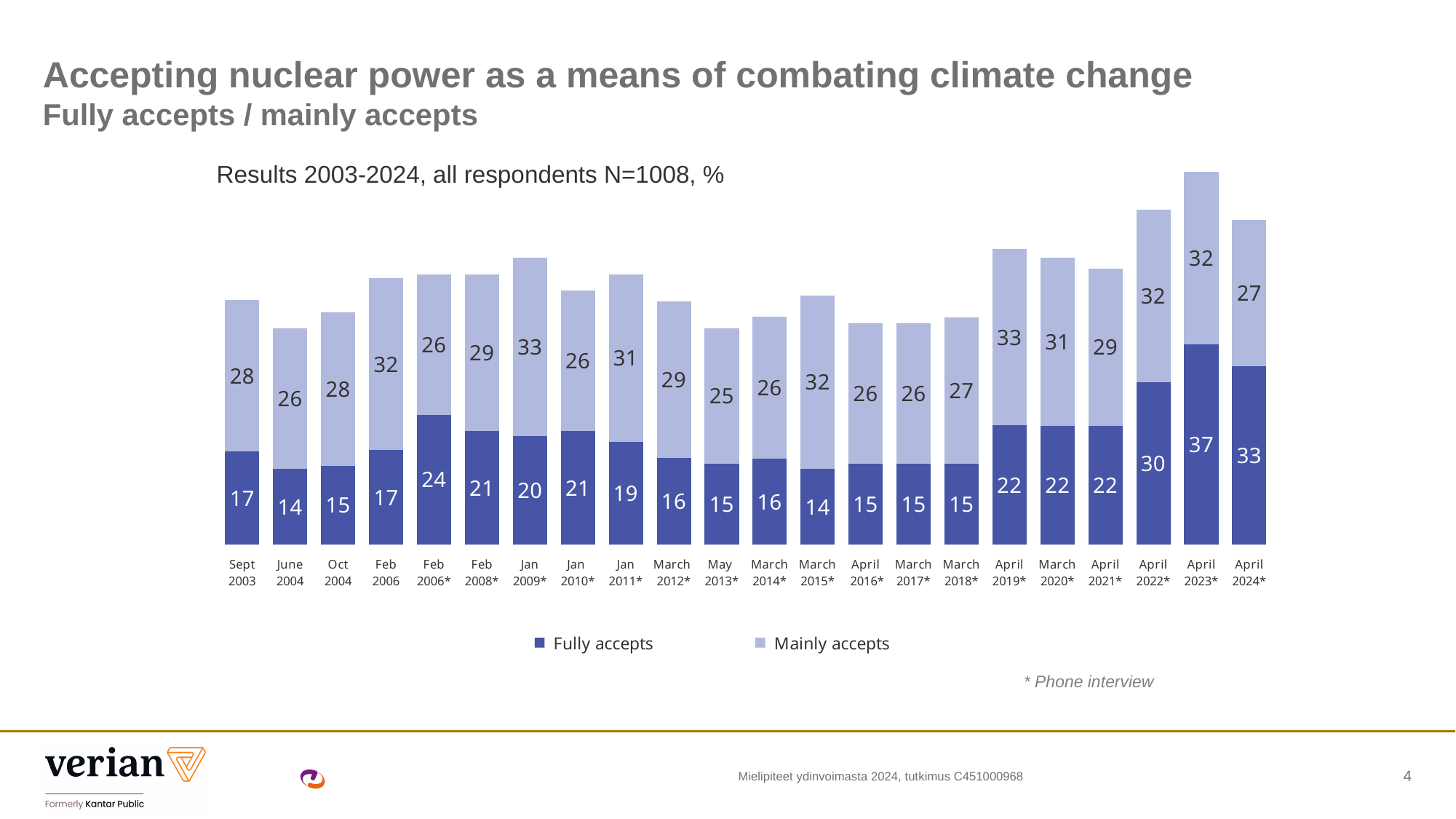
What is the total of the stacked bar for April 2024*? 60 Which is larger: the "Mainly accepts" value for Jan 2009* or for Jan 2010*? Jan 2009* What is the "Fully accepts" value for Sept 2003? 17 Which period has the highest "Fully accepts" value? April 2023* What kind of chart is shown on the slide? Stacked bar chart What is the difference between the "Fully accepts" values for April 2023* and April 2022*? 7 What does the asterisk after a period label indicate, according to the note on the slide? Phone interview What is the "Mainly accepts" value for Feb 2006? 32 What is the "Fully accepts" value for April 2023*? 37 How many series does the legend list? 2 What is the total of the stacked bar for June 2004? 40 How many time periods are shown on the x axis? 22